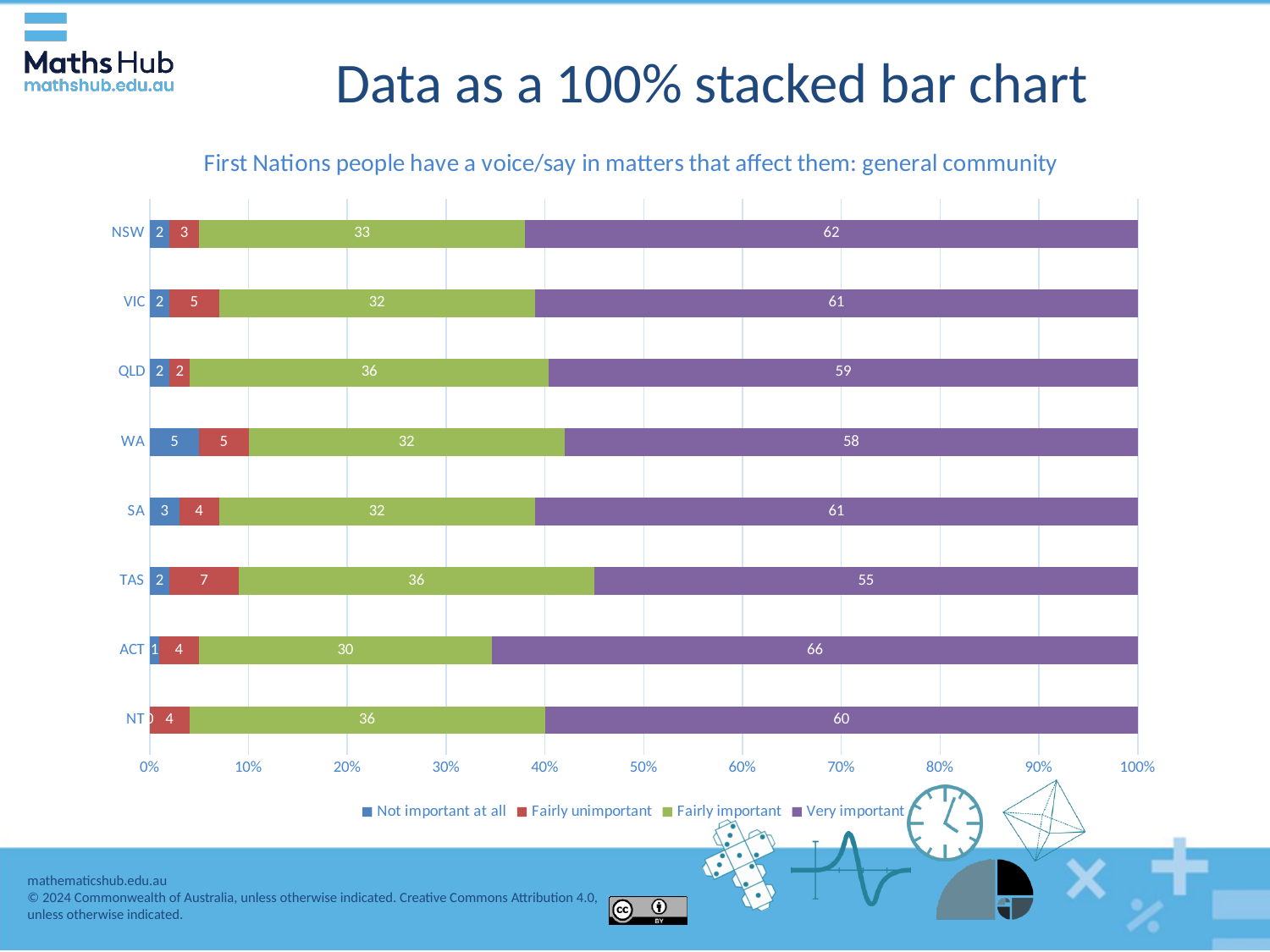
What is the Not important at all value for WA? 5 What is the Fairly important value for QLD? 36 Which state or territory has the lowest Very important value? TAS How many series does the legend list? 4 What percentage of the NSW general community rated the issue as Very important? 62 Which has a larger Fairly important value, ACT or NT? NT What type of chart is shown on the slide? 100% stacked bar chart What is the Fairly unimportant value for TAS? 7 How many states and territories are shown on the chart? 8 Which state or territory has the highest Very important value? ACT Which colour represents the Very important series in the legend? Purple What is the difference between the Very important values for ACT and TAS? 11